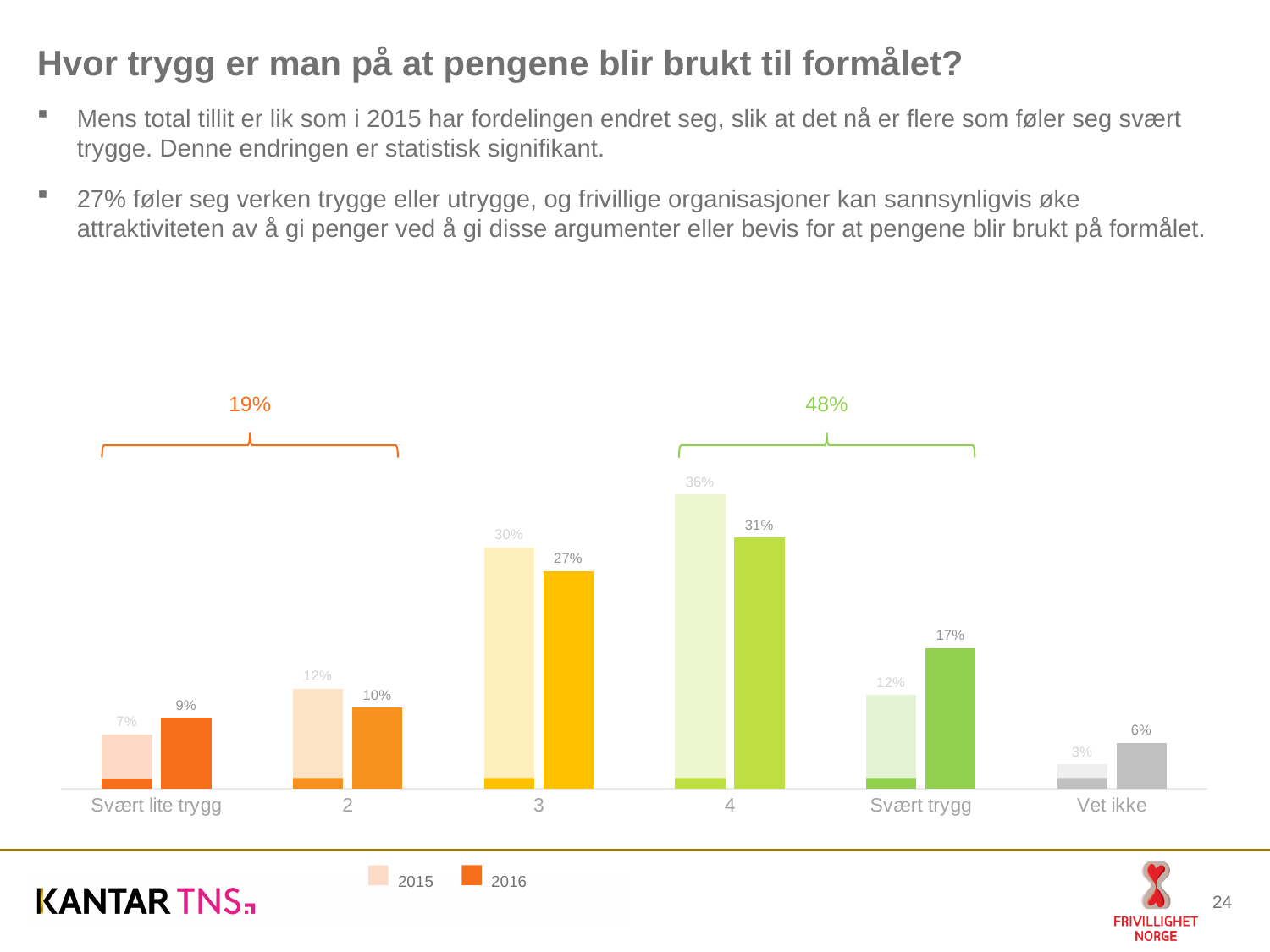
What is the 2015 value for the category '4'? 36% What percentage is shown above the bracket spanning the categories '4' and 'Svært trygg'? 48% What is the 2016 value for 'Svært trygg'? 17% What is the 2015 value for 'Vet ikke'? 3% How many categories are shown on the x axis? 6 What is the 2016 value for the category '3'? 27% Which category has the highest 2016 value? 4 What kind of chart is shown on the slide? Bar chart What is the difference between the 2015 and 2016 values for 'Svært trygg'? 5% Which category has the lowest 2015 value? Vet ikke How many series does the legend list? 2 Which is larger for the category '2': the 2015 value or the 2016 value? 2015